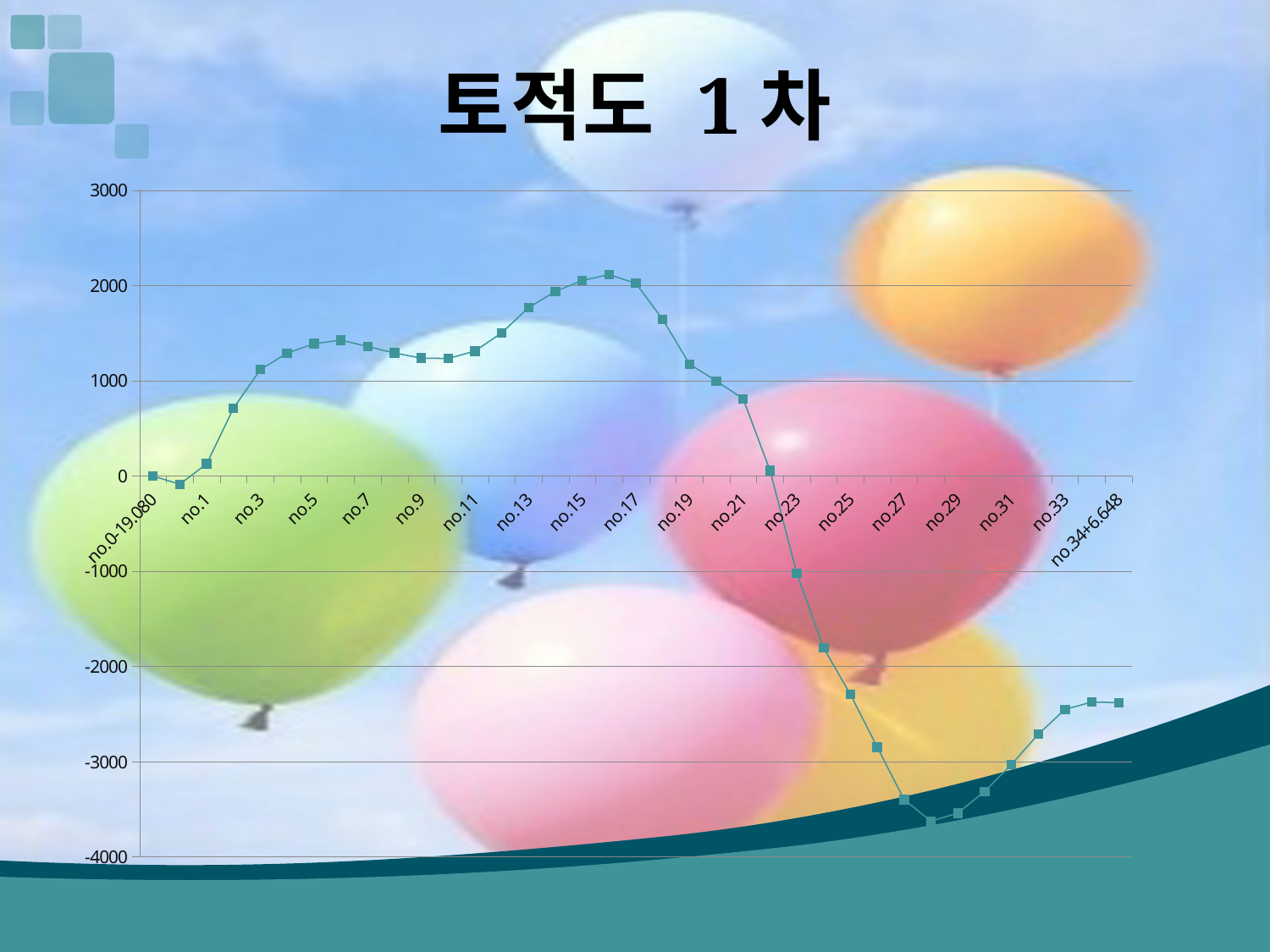
Is the value for no.13 greater or less than 1500? greater Is the value for no.5 greater or less than 1000? greater Which has the larger value, no.3 or no.13? no.13 Is the value for no.27 greater or less than -3000? less Which has the larger value, no.23 or no.27? no.23 Do the values rise or fall from no.17 to no.27? fall What is the title of the chart? 토적도 1 차 How many category labels are shown along the x axis? 19 What kind of chart is shown on the slide? line chart Do the values rise or fall from no.29 to no.33? rise